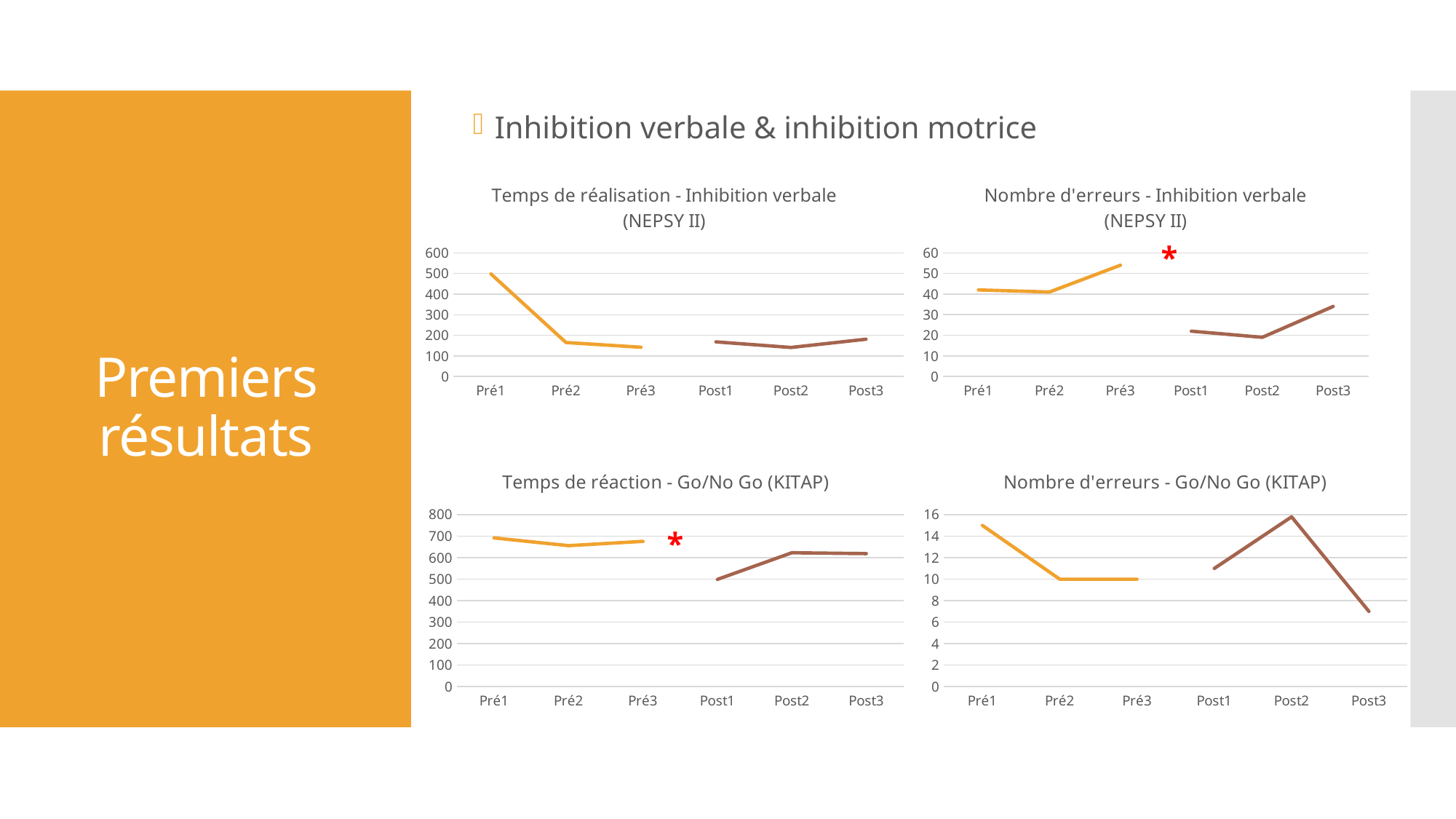
In the chart "Temps de réalisation - Inhibition verbale (NEPSY II)", do the values rise or fall from Pré1 to Pré3? fall In the chart "Temps de réalisation - Inhibition verbale (NEPSY II)", which is larger, the value for Pré1 or Pré2? Pré1 In the chart "Nombre d'erreurs - Go/No Go (KITAP)", what is the value for Pré3? 10 In the chart "Nombre d'erreurs - Go/No Go (KITAP)", how many points are plotted along the x axis? 6 In the chart "Temps de réalisation - Inhibition verbale (NEPSY II)", is the value for Pré1 greater or less than 400? greater What kind of chart is "Temps de réalisation - Inhibition verbale (NEPSY II)"? line chart In the chart "Nombre d'erreurs - Go/No Go (KITAP)", what is the value for Pré2? 10 In the chart "Nombre d'erreurs - Inhibition verbale (NEPSY II)", which point has the highest value? Pré3 In the chart "Nombre d'erreurs - Go/No Go (KITAP)", which point has the lowest value? Post3 In the chart "Temps de réaction - Go/No Go (KITAP)", which point has the lowest value? Post1 In the chart "Temps de réaction - Go/No Go (KITAP)", is the value for Post1 greater or less than 600? less How many charts are shown on the slide? 4